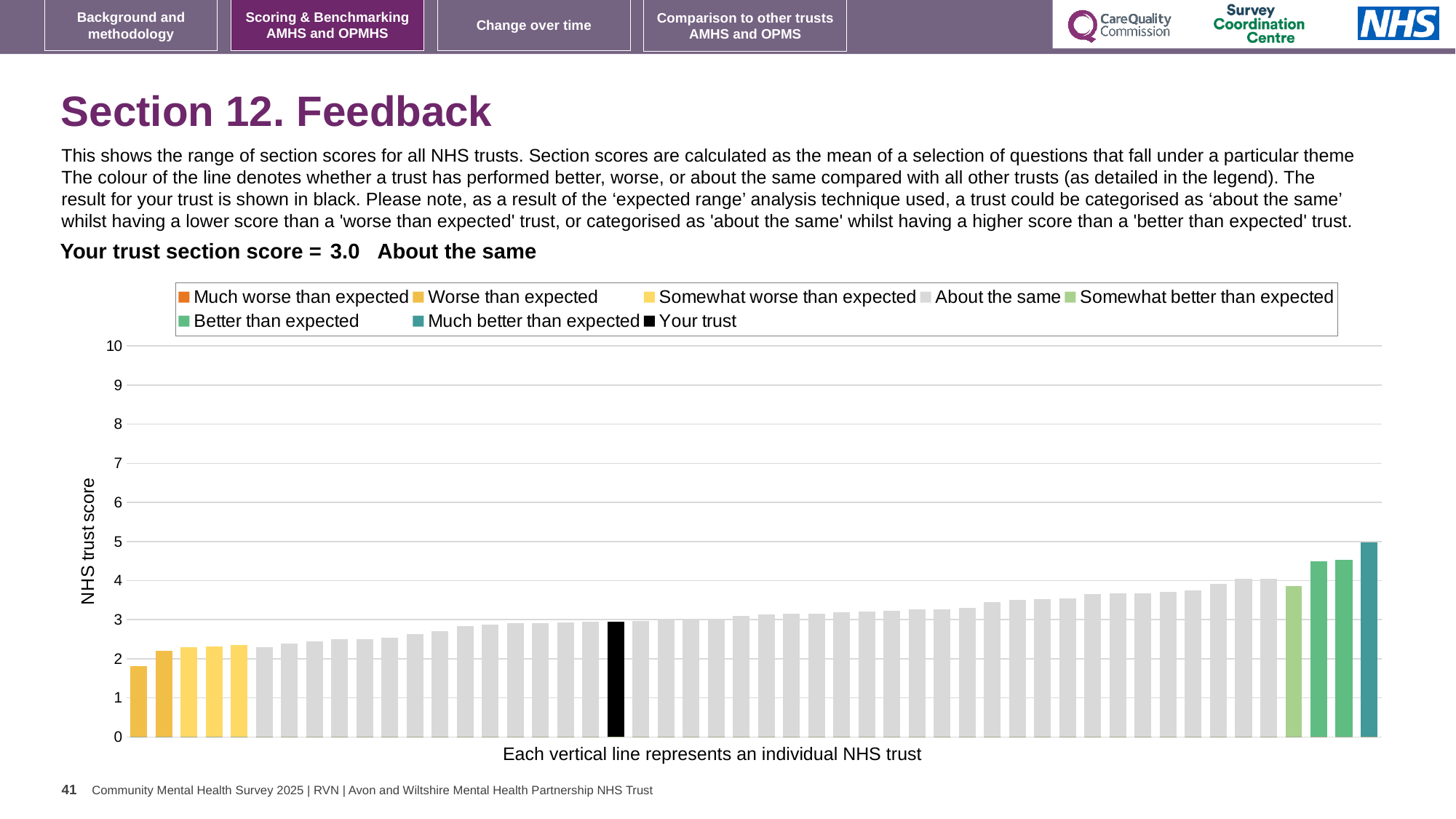
Do the bar values rise or fall from left to right along the x axis? rise How many entries does the chart legend list? 8 Which category is your trust's section score placed in? About the same What is the highest tick value shown on the y axis? 10 Which bar is larger, the leftmost bar or the rightmost bar? the rightmost bar Is the value of the tallest bar (rightmost) greater or less than 4? greater What colour is the bar representing your trust? black What is the label on the y axis of the chart? NHS trust score What is the section score for your trust shown on the slide? 3.0 Is the value of the black bar greater or less than 4? less Is the value of the shortest bar (leftmost) greater or less than 2? less What kind of chart is shown on the slide? bar chart